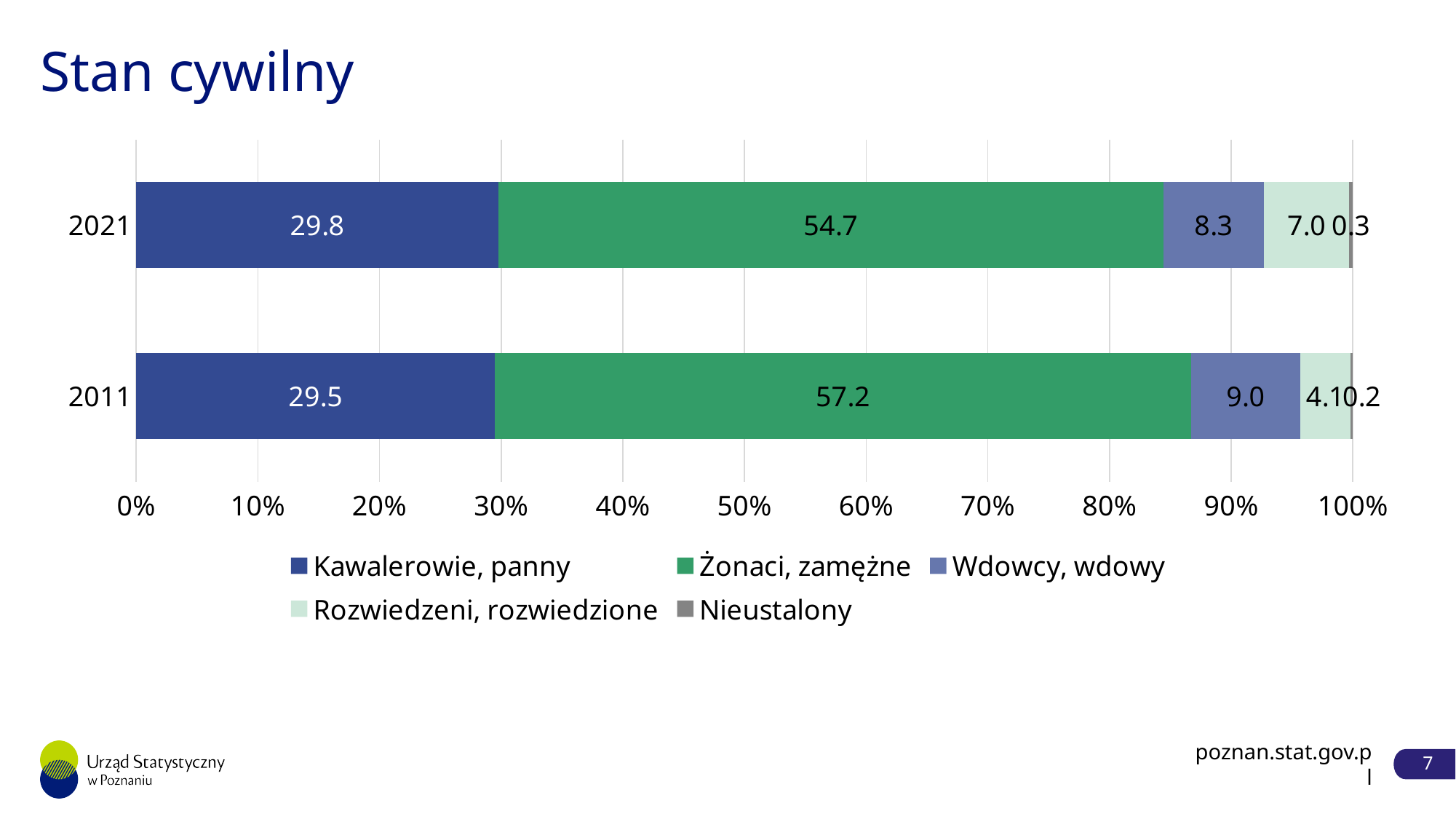
What is the difference between the Żonaci, zamężne values for 2011 and 2021? 2.5 How many years are shown on the chart? 2 What is the value for Kawalerowie, panny in 2011? 29.5 What is the value for Nieustalony in 2021? 0.3 Which series has the largest share in 2011? Żonaci, zamężne Which year has the larger value for Rozwiedzeni, rozwiedzione, 2011 or 2021? 2021 What kind of chart is shown on the slide? stacked bar chart What is the value for Rozwiedzeni, rozwiedzione in 2011? 4.1 What is the value for Żonaci, zamężne in 2021? 54.7 How many series does the legend list? 5 What is the value for Wdowcy, wdowy in 2021? 8.3 Which series has the smallest share in 2021? Nieustalony